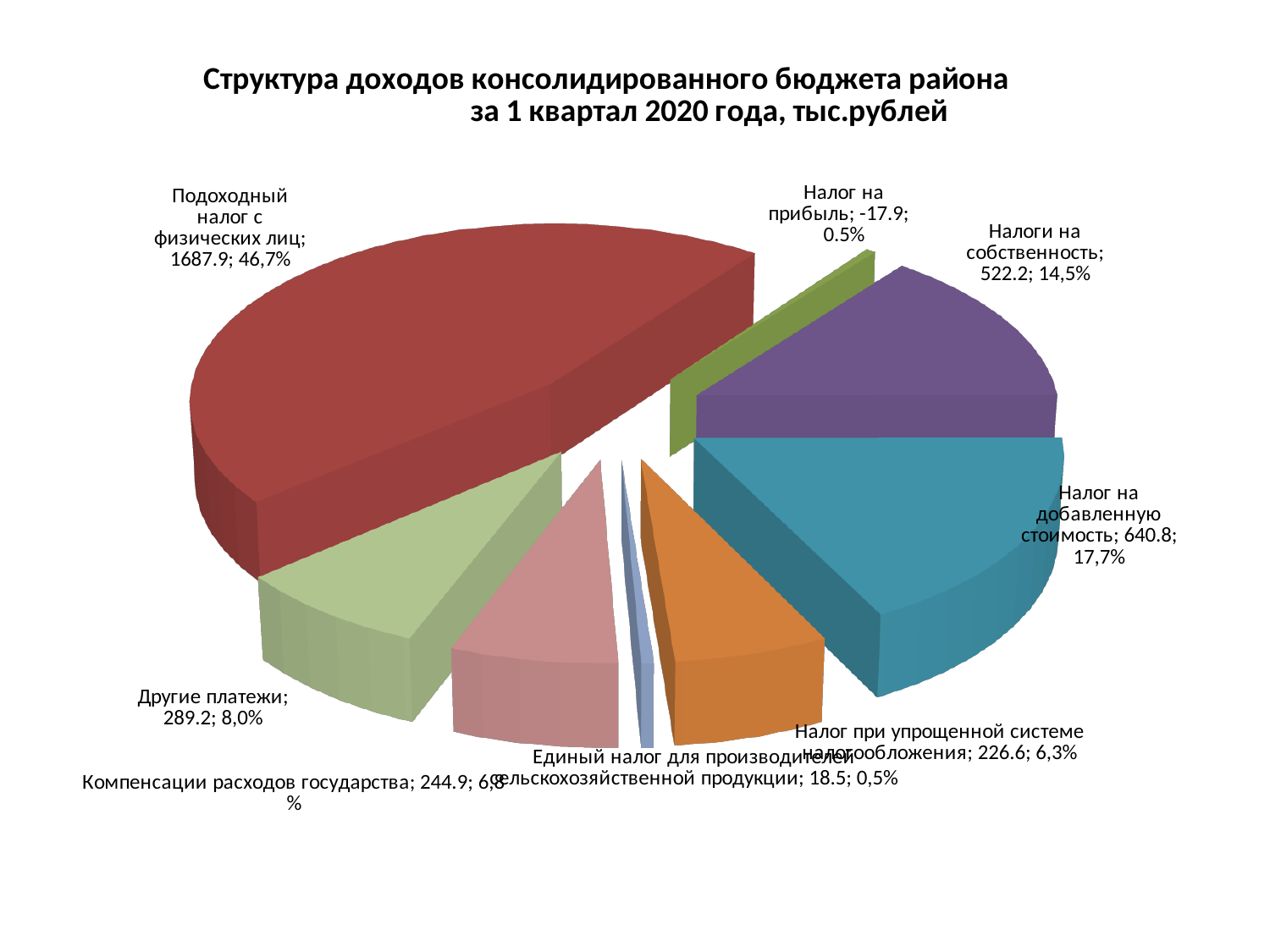
What share of the pie does Другие платежи represent? 8,0% How many categories are shown in the pie chart? 8 What share of the pie does Налог на добавленную стоимость represent? 17,7% Which category has the lowest value? Налог на прибыль What kind of chart is shown on the slide? pie chart Which is larger: the value for Другие платежи or the value for Компенсации расходов государства? Другие платежи What is the value for Налоги на собственность? 522.2 Which category has the largest slice of the pie? Подоходный налог с физических лиц What is the title of the chart? Структура доходов консолидированного бюджета района за 1 квартал 2020 года, тыс.рублей What is the value for Налог при упрощенной системе налогообложения? 226.6 What is the value for Подоходный налог с физических лиц? 1687.9 What is the difference between the values for Налог на добавленную стоимость and Налоги на собственность? 118.6